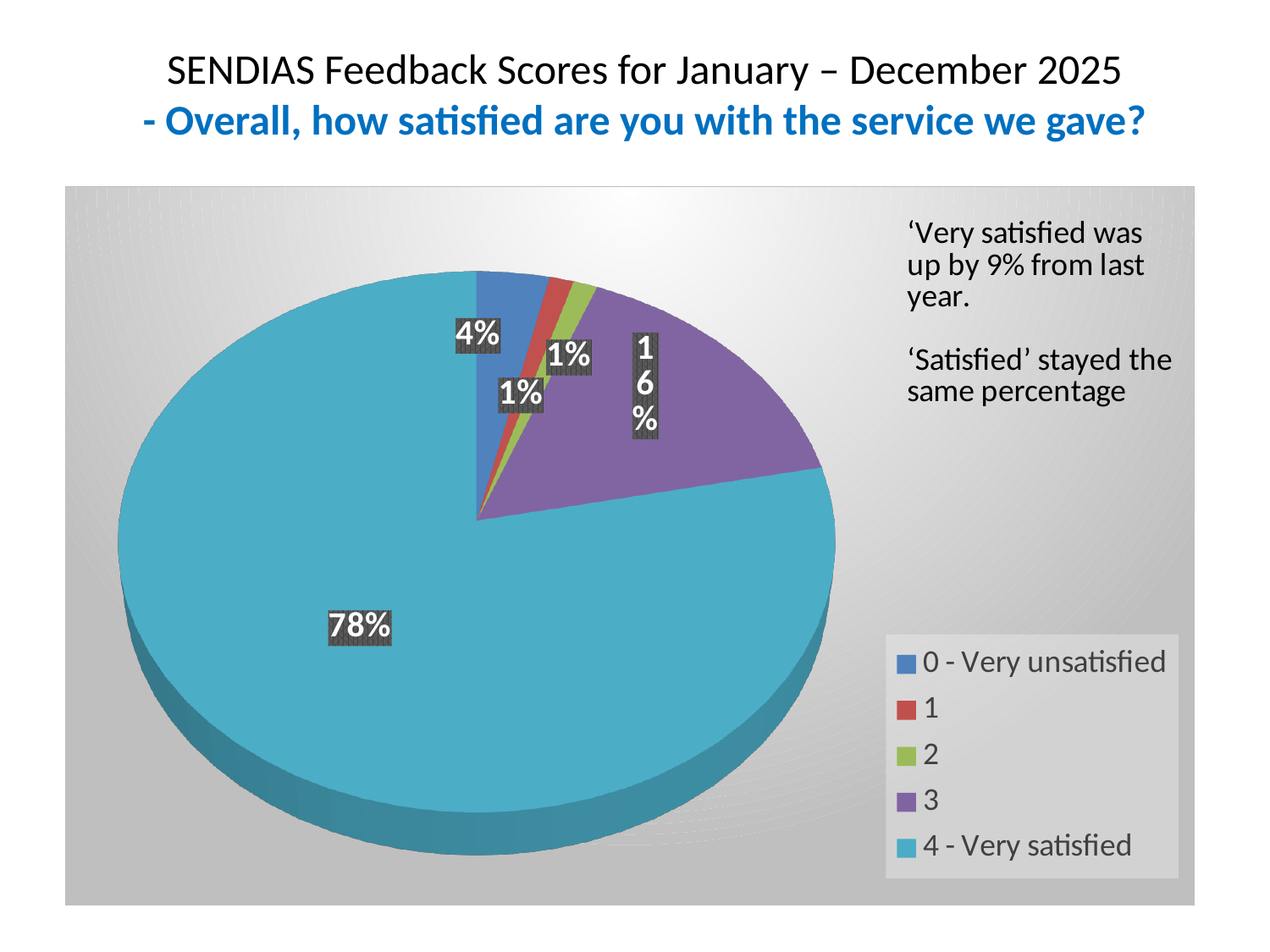
What percentage of the pie is '0 - Very unsatisfied'? 4% Which is larger, the share for category '3' or the share for '0 - Very unsatisfied'? 3 How many categories does the pie chart have? 5 What percentage of the pie is category '3'? 16% What is the difference in percentage points between '4 - Very satisfied' and category '3'? 62 What percentage of the pie is '4 - Very satisfied'? 78% What kind of chart is shown on the slide? Pie chart How many entries does the legend list? 5 What percentage of the pie is category '2'? 1% What colour is the '4 - Very satisfied' slice in the legend? Teal (light blue) What percentage of the pie is category '1'? 1% Which category has the largest share of the pie? 4 - Very satisfied